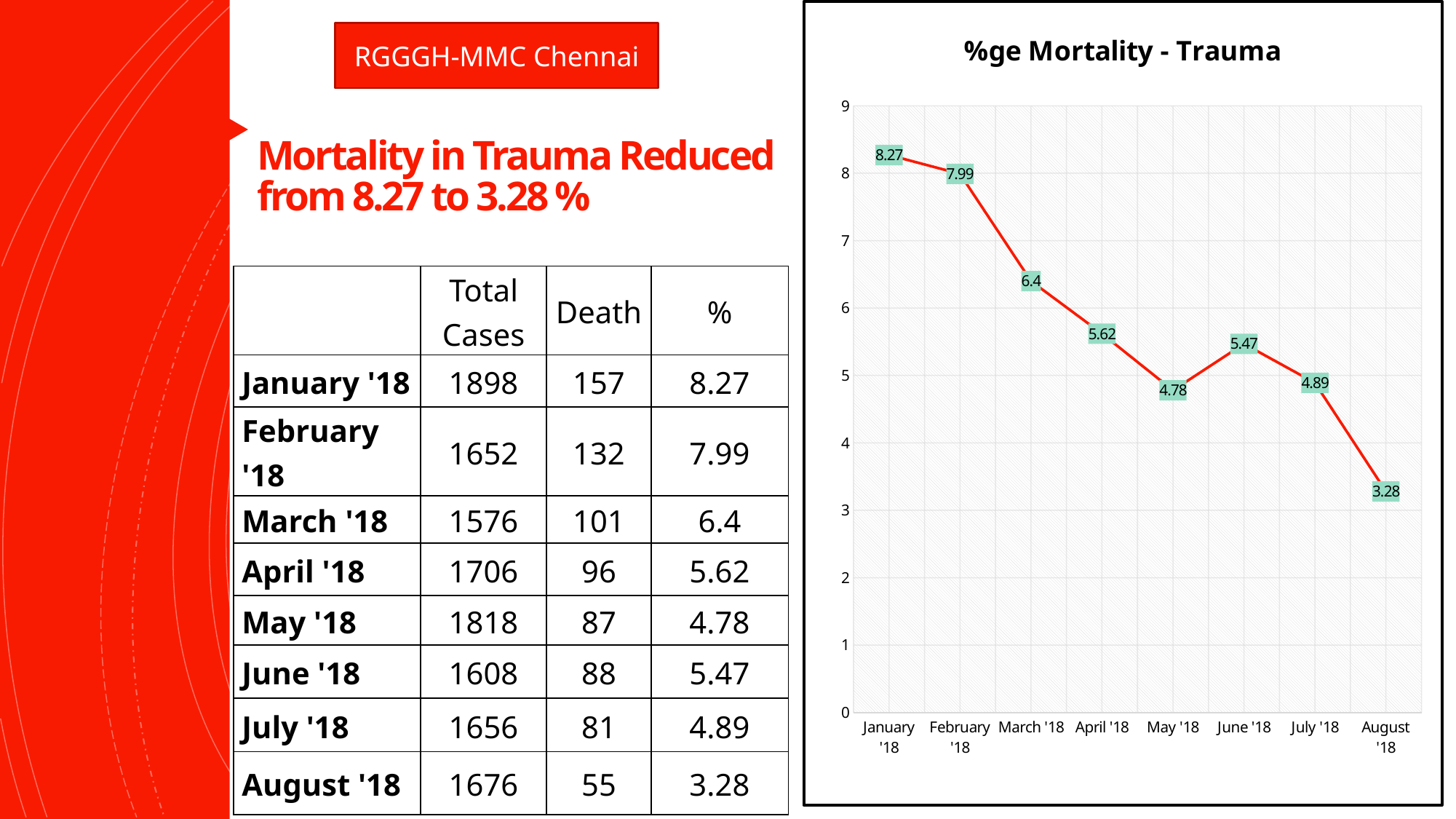
What is the value for August '18 in the %ge Mortality - Trauma chart? 3.28 What is the title of the chart on the slide? %ge Mortality - Trauma What is the difference between the April '18 and May '18 values in the %ge Mortality - Trauma chart? 0.84 In the %ge Mortality - Trauma chart, which is larger, the value for June '18 or July '18? June '18 How many months are plotted in the %ge Mortality - Trauma chart? 8 What is the value for March '18 in the %ge Mortality - Trauma chart? 6.4 Which month has the lowest value in the %ge Mortality - Trauma chart? August '18 What is the difference between the January '18 and August '18 values in the %ge Mortality - Trauma chart? 4.99 What is the value for June '18 in the %ge Mortality - Trauma chart? 5.47 Which month has the highest value in the %ge Mortality - Trauma chart? January '18 Is the value for February '18 in the %ge Mortality - Trauma chart greater or less than 7? greater What kind of chart is the %ge Mortality - Trauma chart? line chart